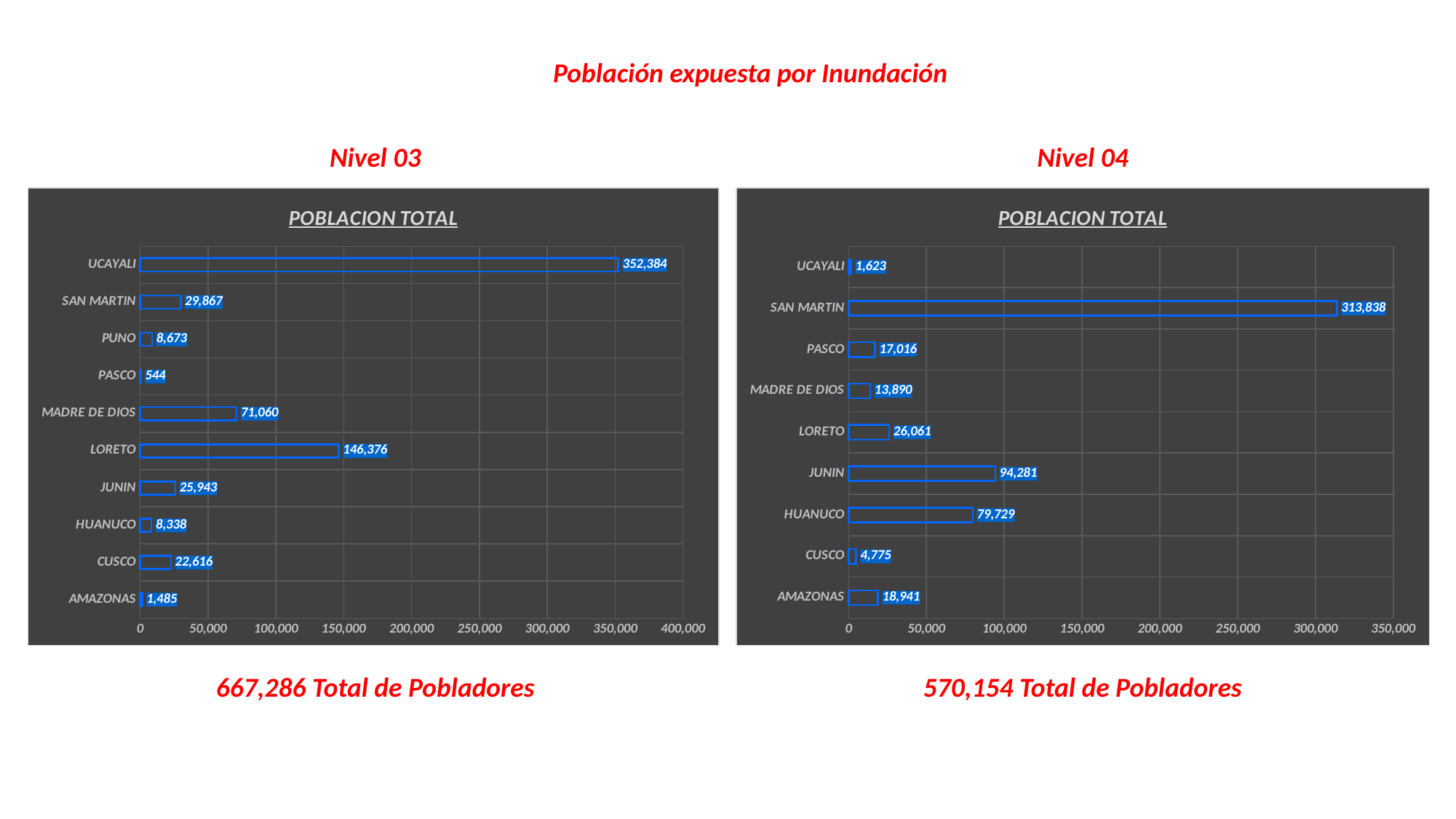
In the Nivel 04 chart on the right, what is the value for HUANUCO? 79,729 In the Nivel 03 chart on the left, what is the value for PASCO? 544 In the Nivel 03 chart on the left, what is the difference between the values for UCAYALI and LORETO? 206,008 In the Nivel 04 chart on the right, what is the difference between the values for JUNIN and HUANUCO? 14,552 In the Nivel 03 chart on the left, what is the value for LORETO? 146,376 In the Nivel 03 chart on the left, which category has the lowest value? PASCO How many categories are shown in the Nivel 03 chart on the left? 10 In the Nivel 04 chart on the right, which category has the lowest value? UCAYALI How many categories are shown in the Nivel 04 chart on the right? 9 In the Nivel 04 chart on the right, which category has the highest value? SAN MARTIN In the Nivel 03 chart on the left, which is larger, the value for MADRE DE DIOS or the value for SAN MARTIN? MADRE DE DIOS What kind of chart is the Nivel 03 chart on the left? Bar chart